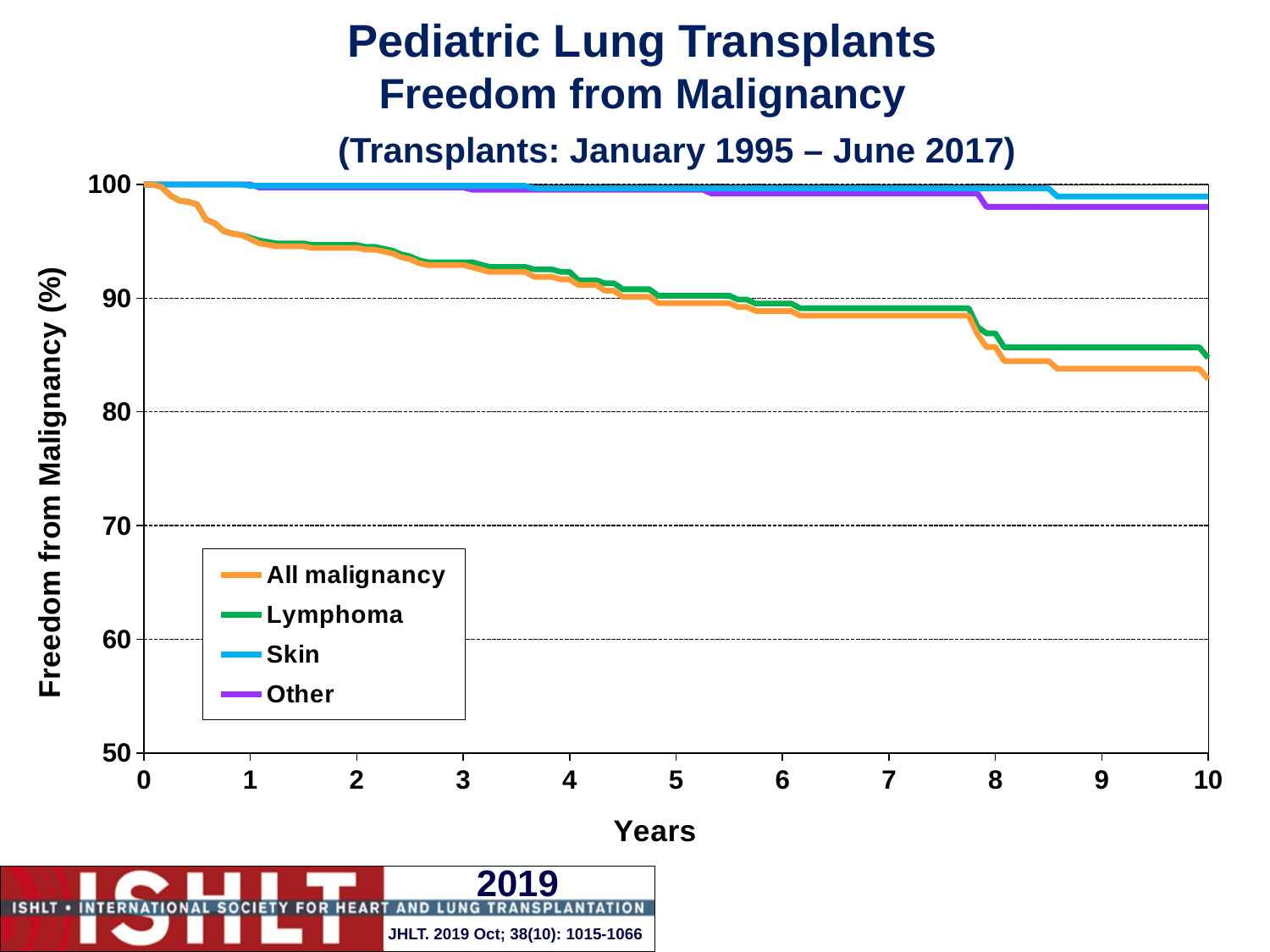
Does the All malignancy curve rise or fall as years increase? fall Is the value for All malignancy at year 10 greater or less than 90? less What is the value of the All malignancy curve at year 0? 100 What kind of chart is shown on the slide? line chart Is the value for Lymphoma at year 10 greater or less than 90? less Which is higher at year 10, the Lymphoma curve or the All malignancy curve? Lymphoma What is the label of the y axis? Freedom from Malignancy (%) Which series has the lowest freedom from malignancy at year 10? All malignancy How many series does the legend list? 4 Is the value for Skin at year 10 greater or less than 90? greater What transplant date range is given in the chart title? January 1995 – June 2017